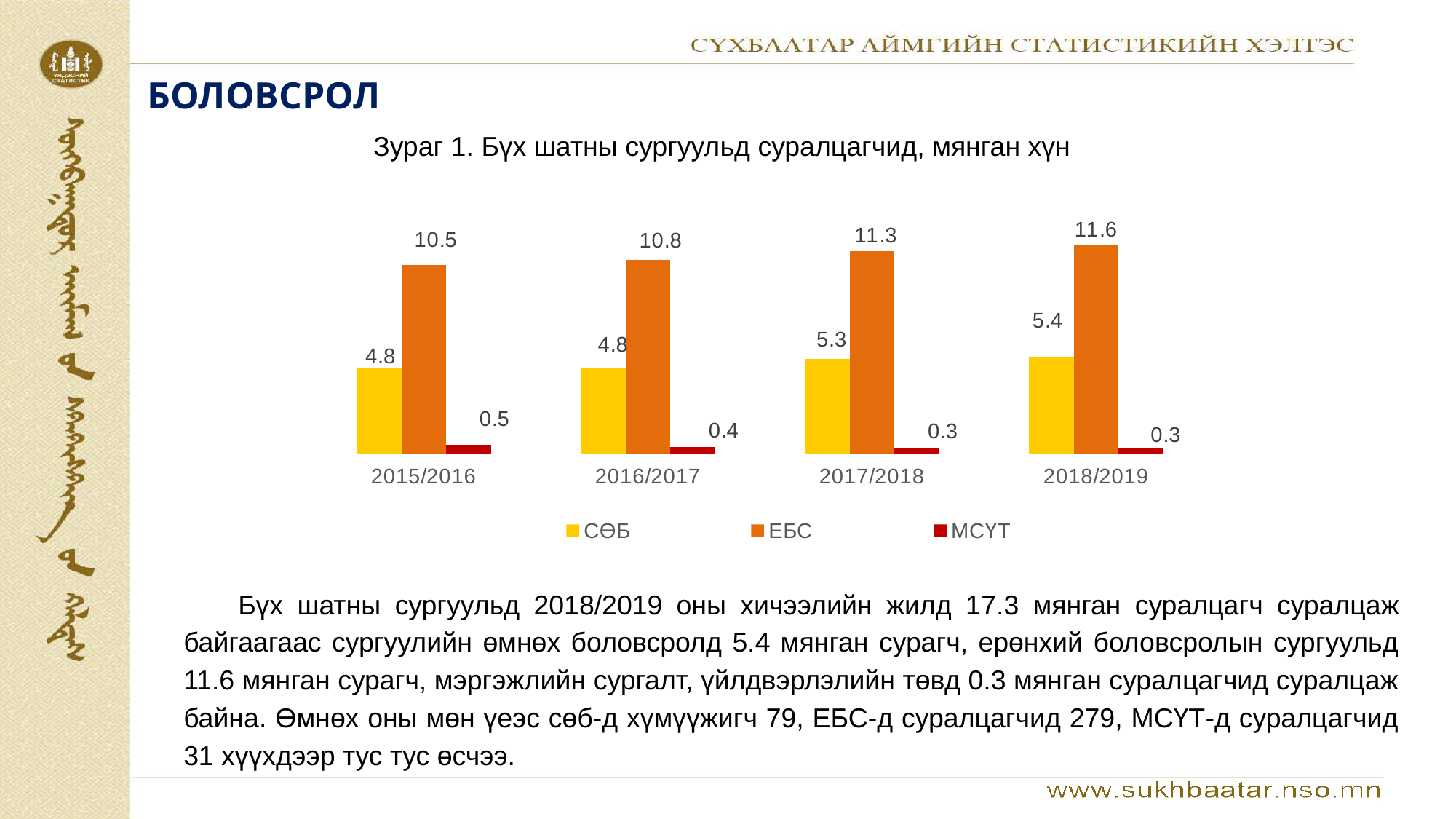
What is the value for ЕБС in 2018/2019? 11.6 What is the value for МСҮТ in 2016/2017? 0.4 How many series does the legend list? 3 What is the difference between the ЕБС values for 2018/2019 and 2015/2016? 1.1 What is the title of the chart? Зураг 1. Бүх шатны сургуульд суралцагчид, мянган хүн Does the ЕБС value rise or fall from 2015/2016 to 2018/2019? rise In which year is the ЕБС value highest? 2018/2019 In which year is the МСҮТ value highest? 2015/2016 Which is larger in 2017/2018: СӨБ or ЕБС? ЕБС How many years are shown on the x axis? 4 What is the value for СӨБ in 2015/2016? 4.8 What kind of chart is shown? bar chart